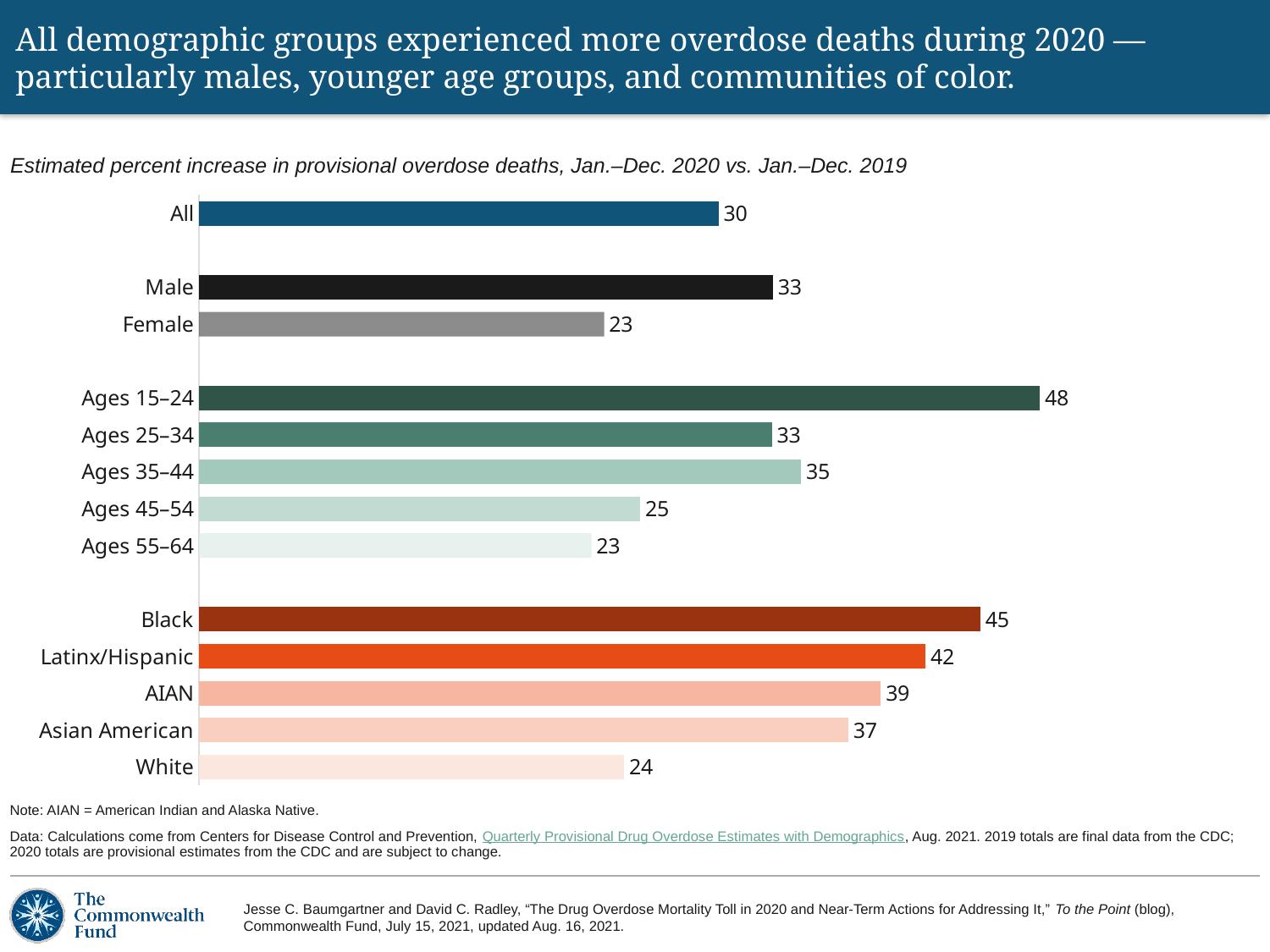
What type of chart is shown on the slide? Bar chart What is the value shown for the All category? 30 Which is larger, the value for Latinx/Hispanic or the value for AIAN? Latinx/Hispanic What does the note on the slide say AIAN stands for? American Indian and Alaska Native What is the estimated percent increase in overdose deaths for Ages 15–24? 48 What is the difference between the values for Black and White? 21 What is the value shown for Female? 23 Among the race/ethnicity categories (Black, Latinx/Hispanic, AIAN, Asian American, White), which has the lowest value? White What is the value shown for Black? 45 How many categories (bars) are shown on the chart? 13 What is the difference between the values for Male and Female? 10 Which category has the highest value on the chart? Ages 15–24